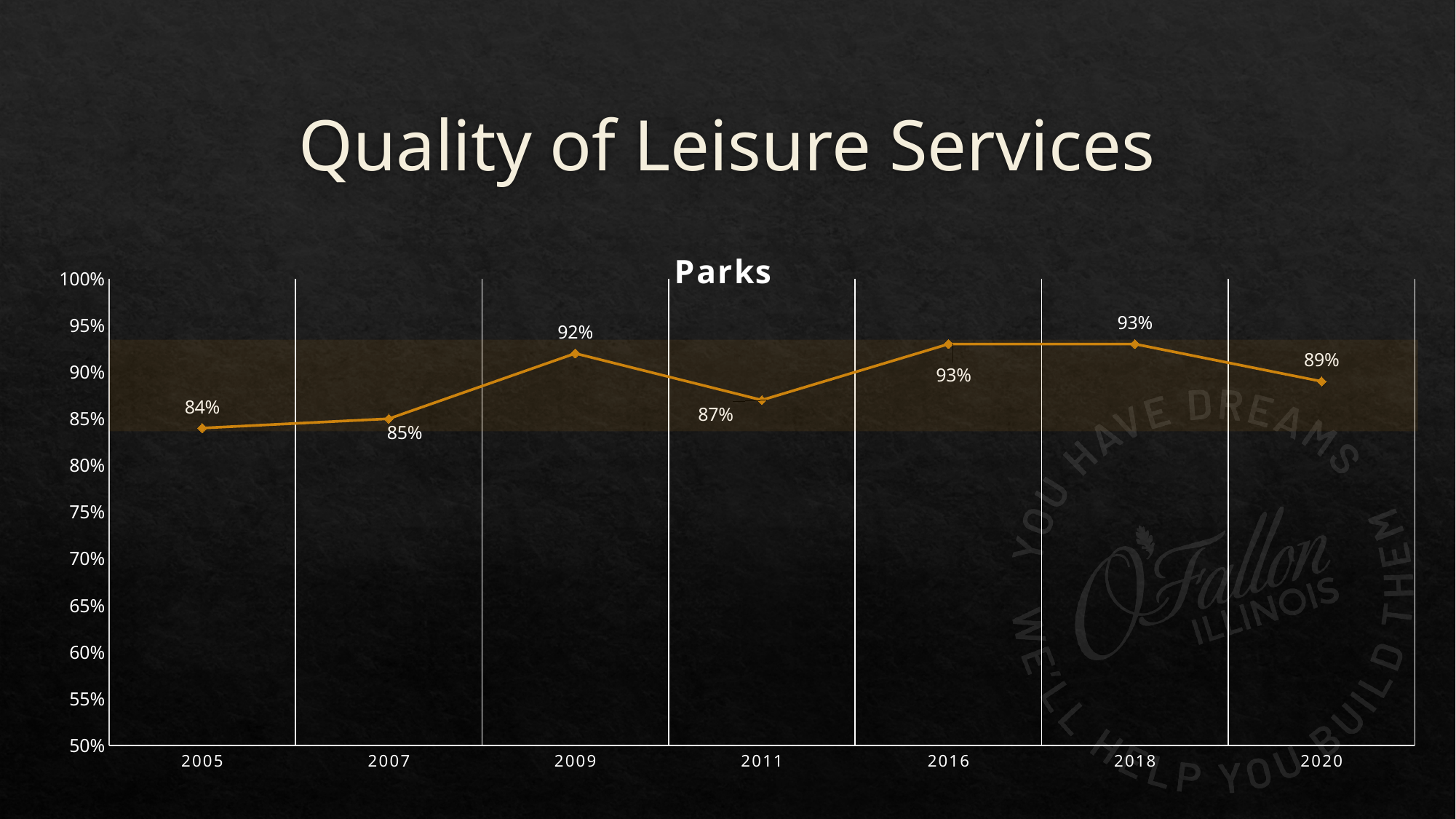
What is the value for 2005 in the Parks chart? 84% How many years are plotted in the Parks chart? 7 What is the value for 2009 in the Parks chart? 92% Is the value for 2007 in the Parks chart greater or less than 90%? less Does the value in the Parks chart rise or fall from 2005 to 2009? rise Which is larger in the Parks chart, the value for 2011 or the value for 2016? 2016 What is the difference between the values for 2009 and 2007 in the Parks chart? 7% What kind of chart is the Parks chart? line chart What is the value for 2011 in the Parks chart? 87% What is the value for 2020 in the Parks chart? 89% What is the difference between the values for 2018 and 2020 in the Parks chart? 4% Which year has the lowest value in the Parks chart? 2005